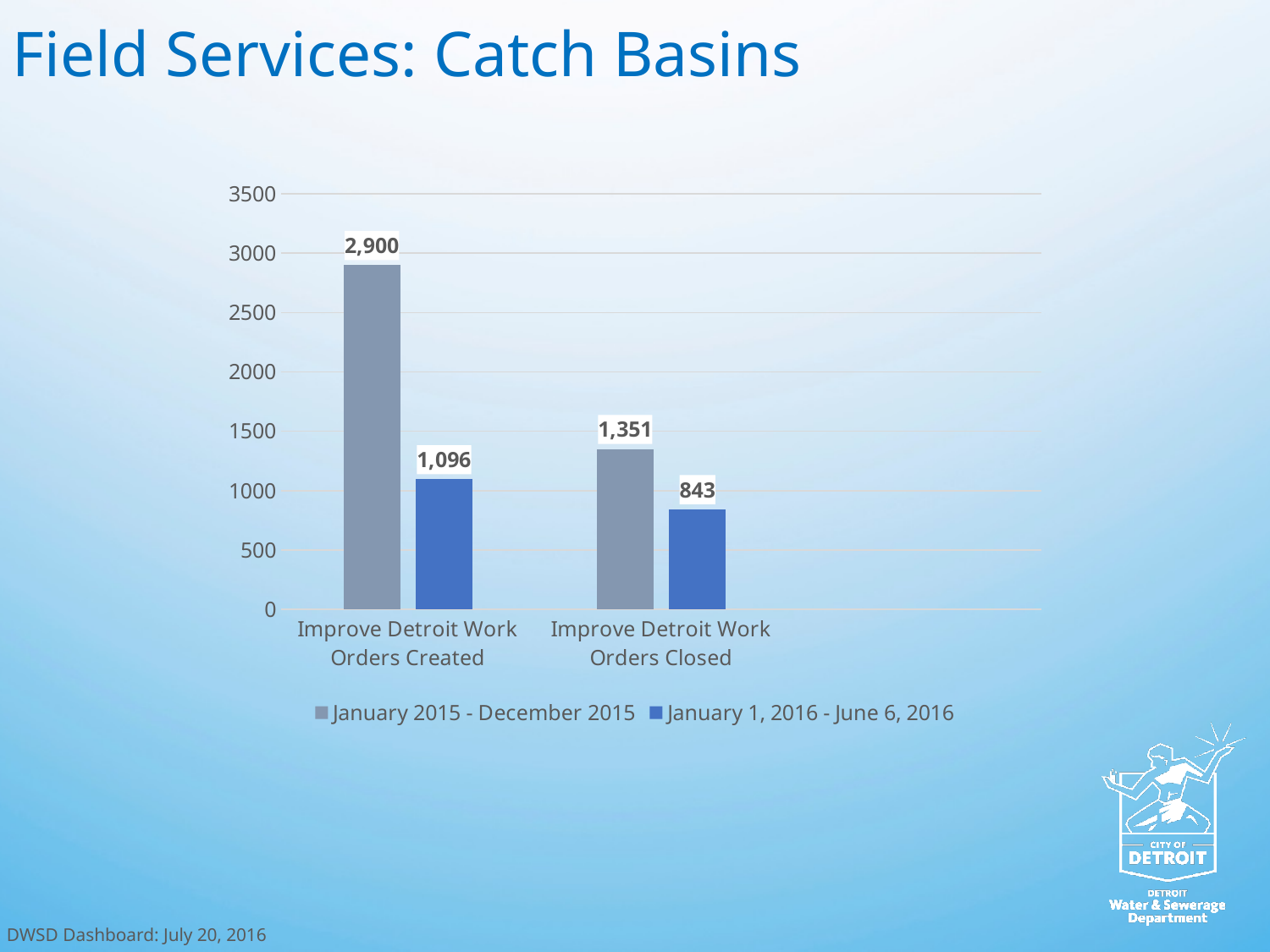
What kind of chart is shown on the slide? Bar chart Which is larger: Work Orders Created in January 1, 2016 - June 6, 2016 or Work Orders Closed in January 2015 - December 2015? Work Orders Closed in January 2015 - December 2015 Which bar has the highest value on the chart? Improve Detroit Work Orders Created, January 2015 - December 2015 Which bar has the lowest value on the chart? Improve Detroit Work Orders Closed, January 1, 2016 - June 6, 2016 What is the value for Improve Detroit Work Orders Created in the January 2015 - December 2015 series? 2,900 What is the value for Improve Detroit Work Orders Closed in the January 1, 2016 - June 6, 2016 series? 843 What is the value for Improve Detroit Work Orders Created in the January 1, 2016 - June 6, 2016 series? 1,096 What is the difference between the two series for Improve Detroit Work Orders Closed? 508 What is the difference between the January 2015 - December 2015 values for Work Orders Created and Work Orders Closed? 1,549 How many categories are shown on the x axis? 2 What is the value for Improve Detroit Work Orders Closed in the January 2015 - December 2015 series? 1,351 How many series does the legend list? 2